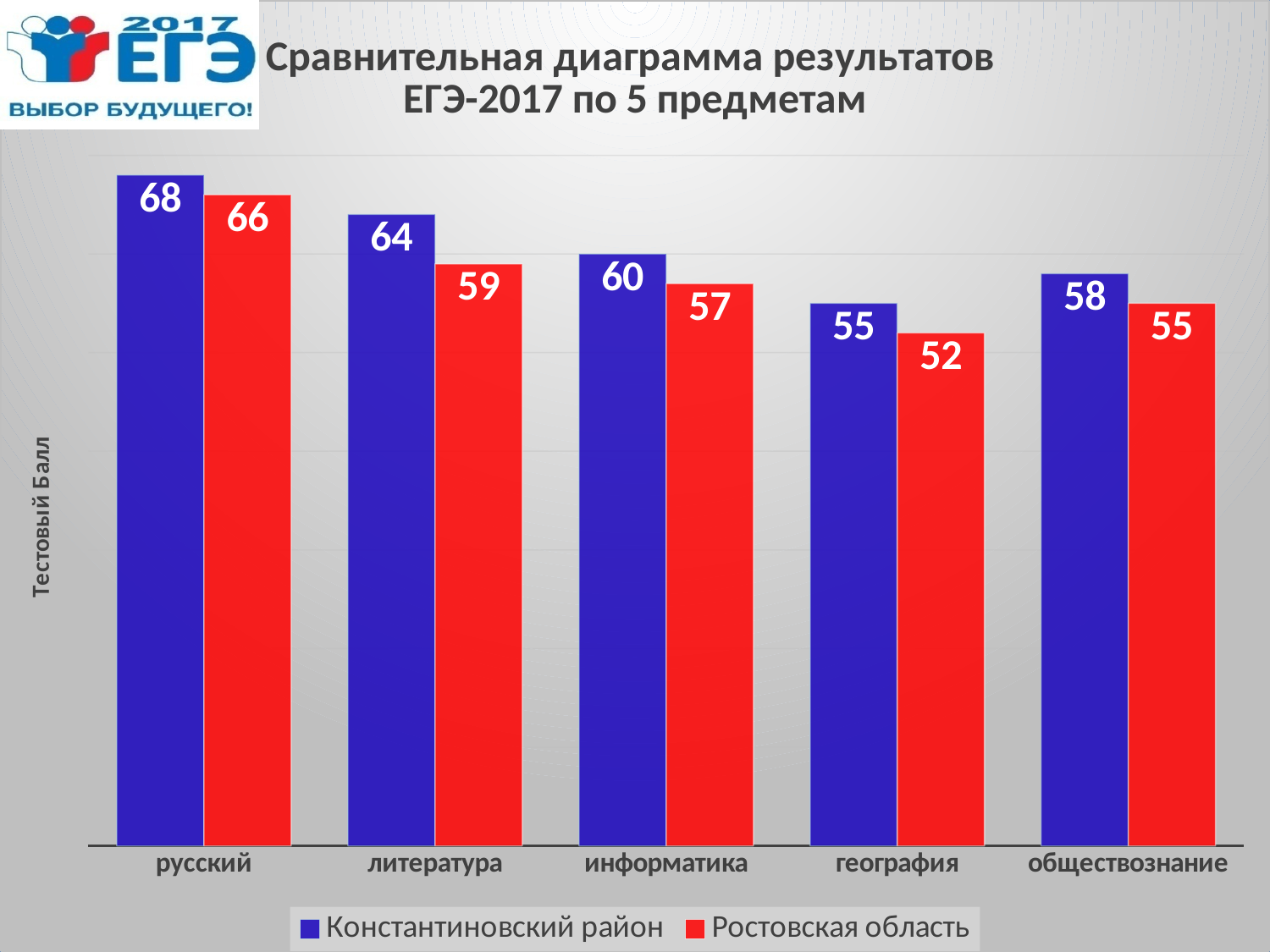
Which is larger in обществознание: Константиновский район or Ростовская область? Константиновский район What is the label of the vertical axis? Тестовый Балл Which subject has the highest value for Константиновский район? русский How many series does the legend list? 2 What is the value for Ростовская область in литература? 59 What kind of chart is shown on the slide? bar chart How many subjects are shown on the x axis? 5 What is the difference between Константиновский район and Ростовская область in информатика? 3 What is the difference between Константиновский район and Ростовская область in литература? 5 What is the value for Константиновский район in русский? 68 What is the value for Ростовская область in география? 52 Which subject has the lowest value for Ростовская область? география